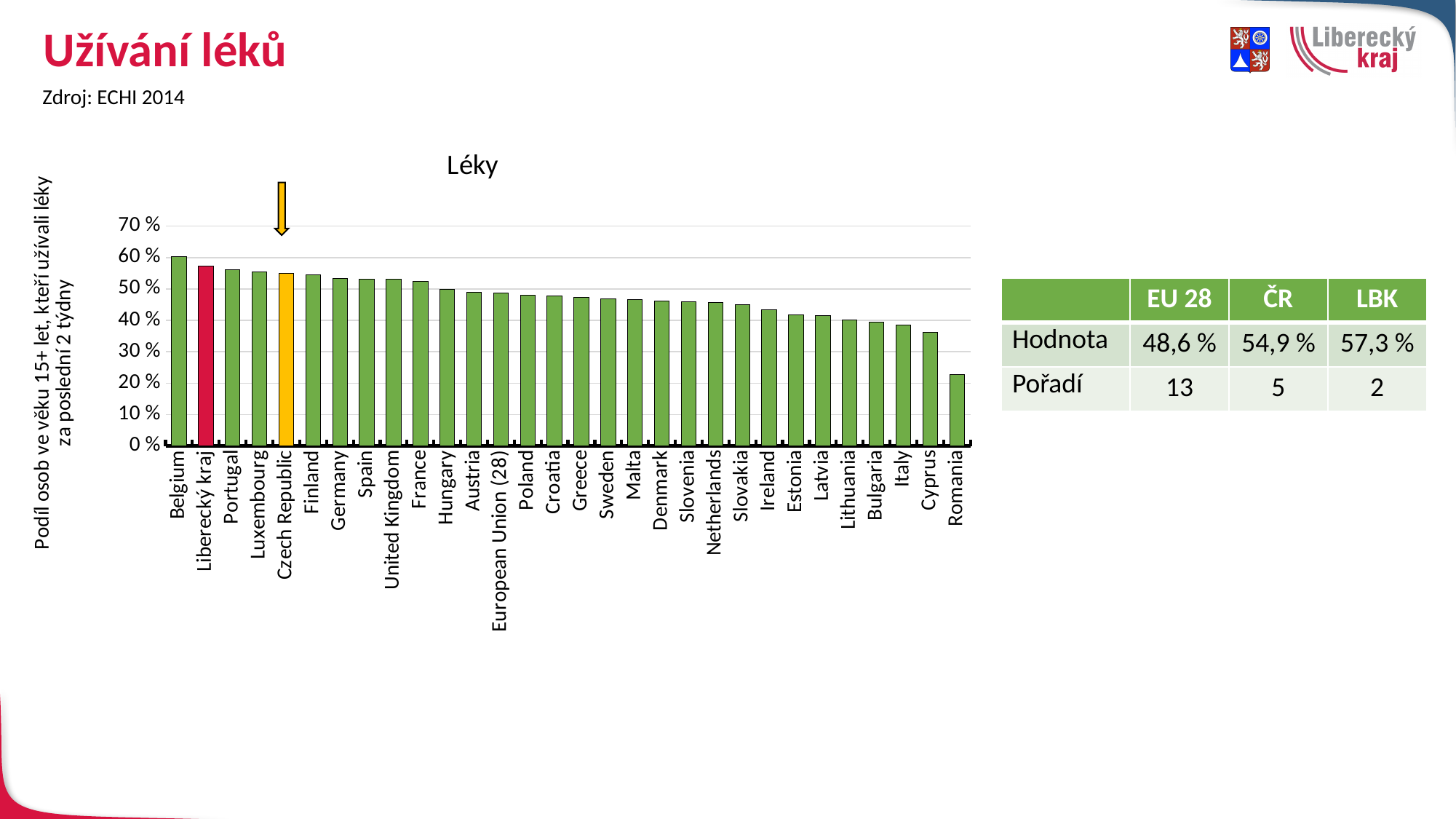
Which category has the lowest value in the chart? Romania Is the value for Romania greater or less than 30 %? less What kind of chart is shown on the slide? bar chart Do the values rise or fall from left to right along the x axis? fall Which has the larger value, Portugal or Italy? Portugal Is the value for Belgium greater or less than 50 %? greater What is the title of the chart? Léky Which category has the highest value in the chart? Belgium According to the table on the slide, what is the value (Hodnota) for LBK? 57,3 % According to the table on the slide, what is the difference between the LBK value and the ČR value? 2,4 % Is the value for Cyprus greater or less than 40 %? less How many bars (categories) does the chart show? 30